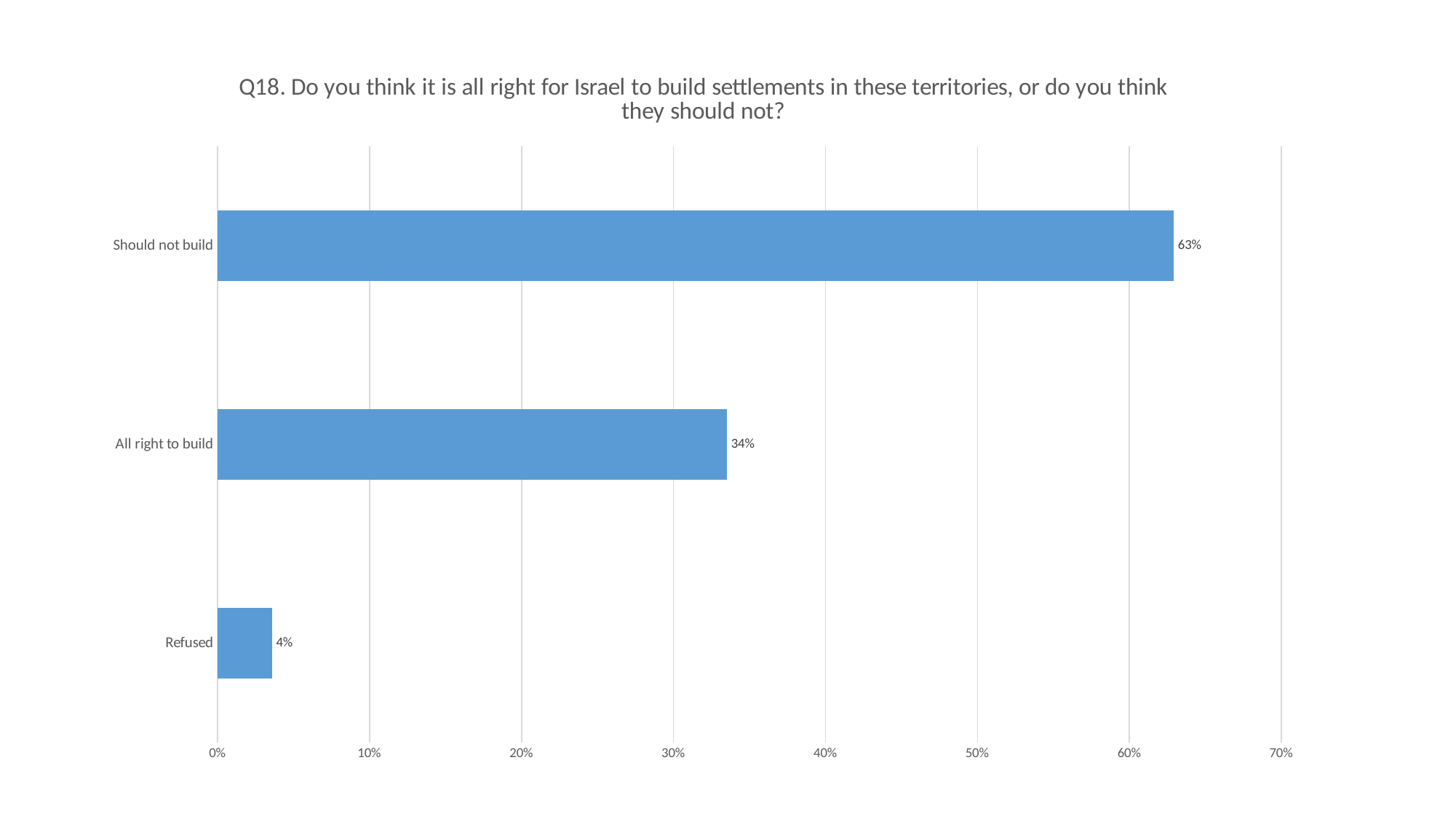
What kind of chart is shown on the slide? Bar chart Is the value for "All right to build" greater or less than 40%? less Which is larger, "All right to build" or "Refused"? All right to build What is the value for "All right to build"? 34% How many categories are shown in the chart? 3 What percentage of respondents said Israel should not build settlements? 63% What is the highest value shown on the x axis? 70% Which category has the highest value? Should not build Which category has the lowest value? Refused What percentage of respondents refused to answer? 4% Is the value for "Should not build" greater or less than 50%? greater What is the difference between "Should not build" and "All right to build"? 29 percentage points